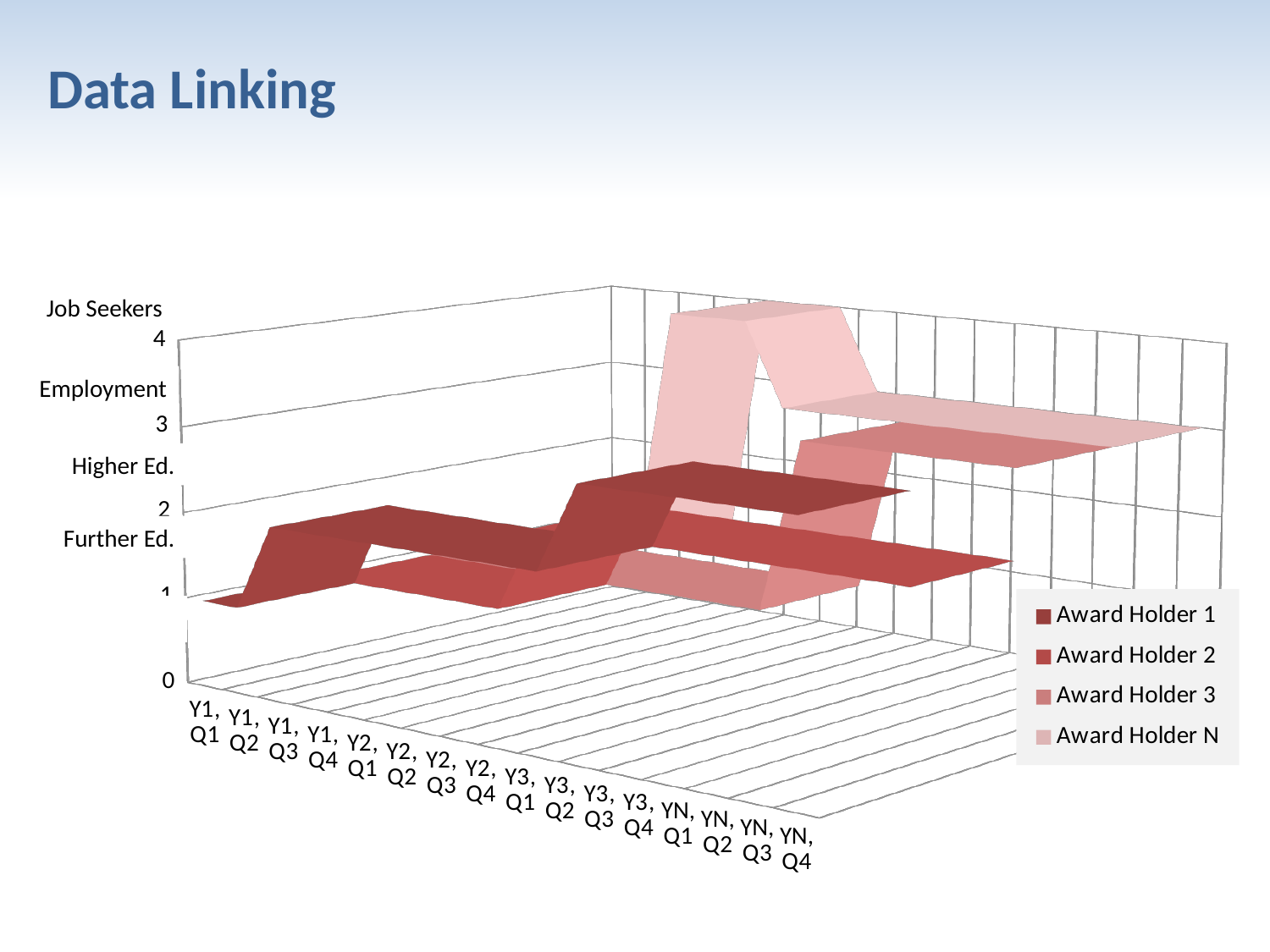
How many series does the legend list? 4 What is the first category label on the x axis? Y1, Q1 What is the title of the slide containing the chart? Data Linking What is the last series listed in the legend? Award Holder N What is the highest numeric tick shown on the vertical axis? 4 How many categories are shown along the x axis? 16 What kind of chart is shown on the slide? 3D line chart What is the last category label on the x axis? YN, Q4